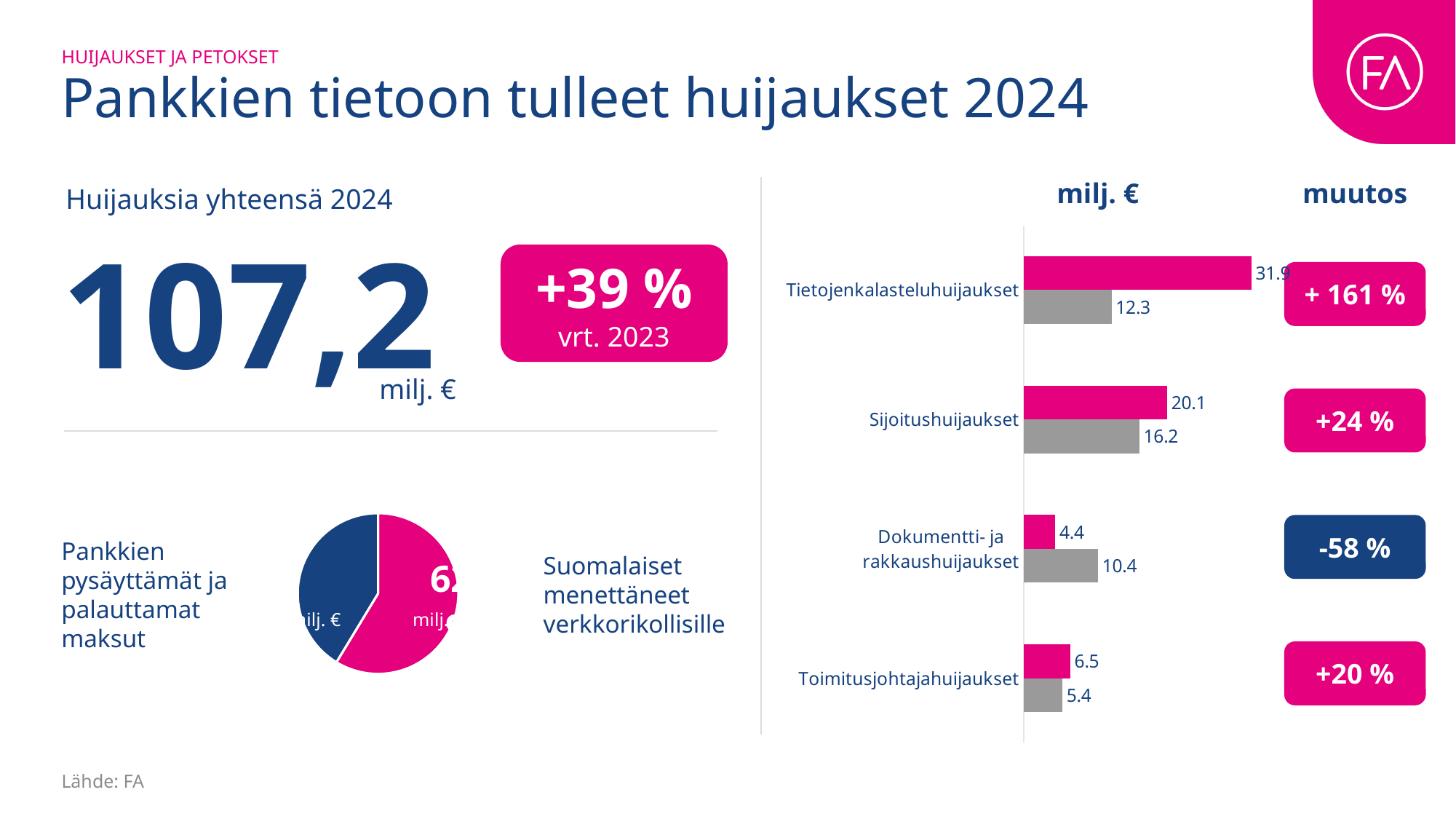
In the bar chart on the right, which is larger for Dokumentti- ja rakkaushuijaukset: the pink bar or the grey bar? the grey bar In the bar chart on the right, what is the 'muutos' value shown for Sijoitushuijaukset? +24 % What kind of chart is shown on the right side of the slide? bar chart In the pie chart on the left, which slice is larger: the pink slice or the blue slice? the pink slice In the bar chart on the right, what is the grey (lower) bar value for Dokumentti- ja rakkaushuijaukset? 10.4 How many categories are shown in the bar chart on the right? 4 In the bar chart on the right, which category has the lowest grey (lower) bar value? Toimitusjohtajahuijaukset In the bar chart on the right, what is the pink (upper) bar value for Tietojenkalasteluhuijaukset? 31.9 In the bar chart on the right, what is the grey (lower) bar value for Sijoitushuijaukset? 16.2 In the bar chart on the right, which category has the highest pink (upper) bar value? Tietojenkalasteluhuijaukset In the bar chart on the right, what is the difference between the pink and grey bar values for Tietojenkalasteluhuijaukset? 19.6 In the bar chart on the right, what is the pink (upper) bar value for Toimitusjohtajahuijaukset? 6.5